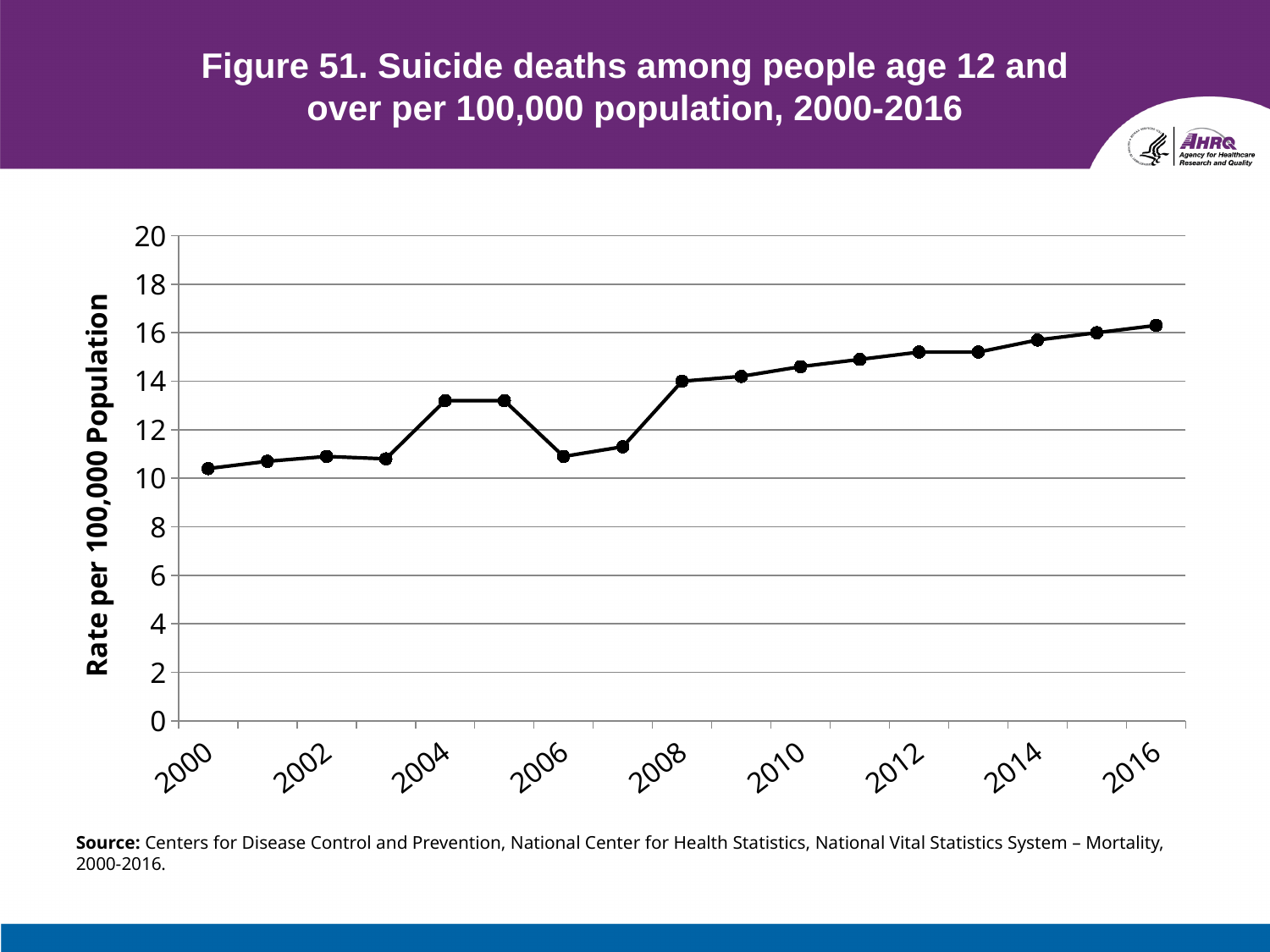
Is the value for 2006 greater or less than 12? less Overall, does the suicide death rate rise or fall from 2000 to 2016? rise How many data points are plotted on the line? 17 Is the value for 2012 greater or less than 14? greater Is the value for 2004 greater or less than 12? greater Which year has the larger value, 2000 or 2008? 2008 What kind of chart is shown on the slide? line chart Which year has the highest suicide death rate on the chart? 2016 Which year has the lowest suicide death rate on the chart? 2000 Which year has the larger value, 2004 or 2006? 2004